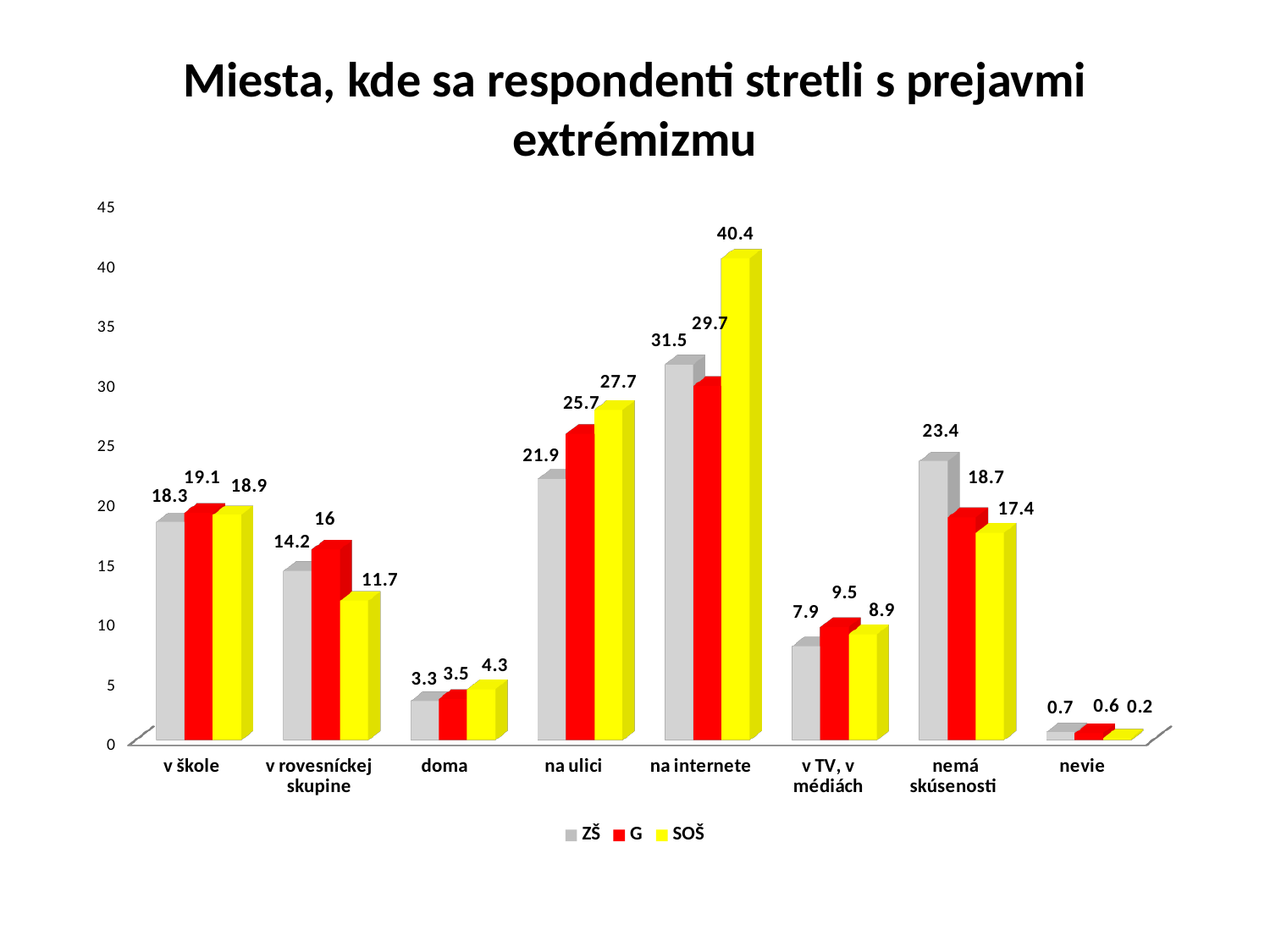
Which category has the lowest value for the SOŠ series? nevie What is the title of the chart? Miesta, kde sa respondenti stretli s prejavmi extrémizmu What is the value for SOŠ in the 'na internete' category? 40.4 What kind of chart is shown on the slide? bar chart Which colour represents the G series in the legend? red What is the value for ZŠ in the 'nemá skúsenosti' category? 23.4 Which category has the highest value for the ZŠ series? na internete What is the difference between the SOŠ and ZŠ values in the 'na internete' category? 8.9 What is the value for G in the 'v rovesníckej skupine' category? 16 How many series does the legend list? 3 Which is larger in the 'v rovesníckej skupine' category: the ZŠ value or the SOŠ value? ZŠ How many categories are shown on the x axis? 8